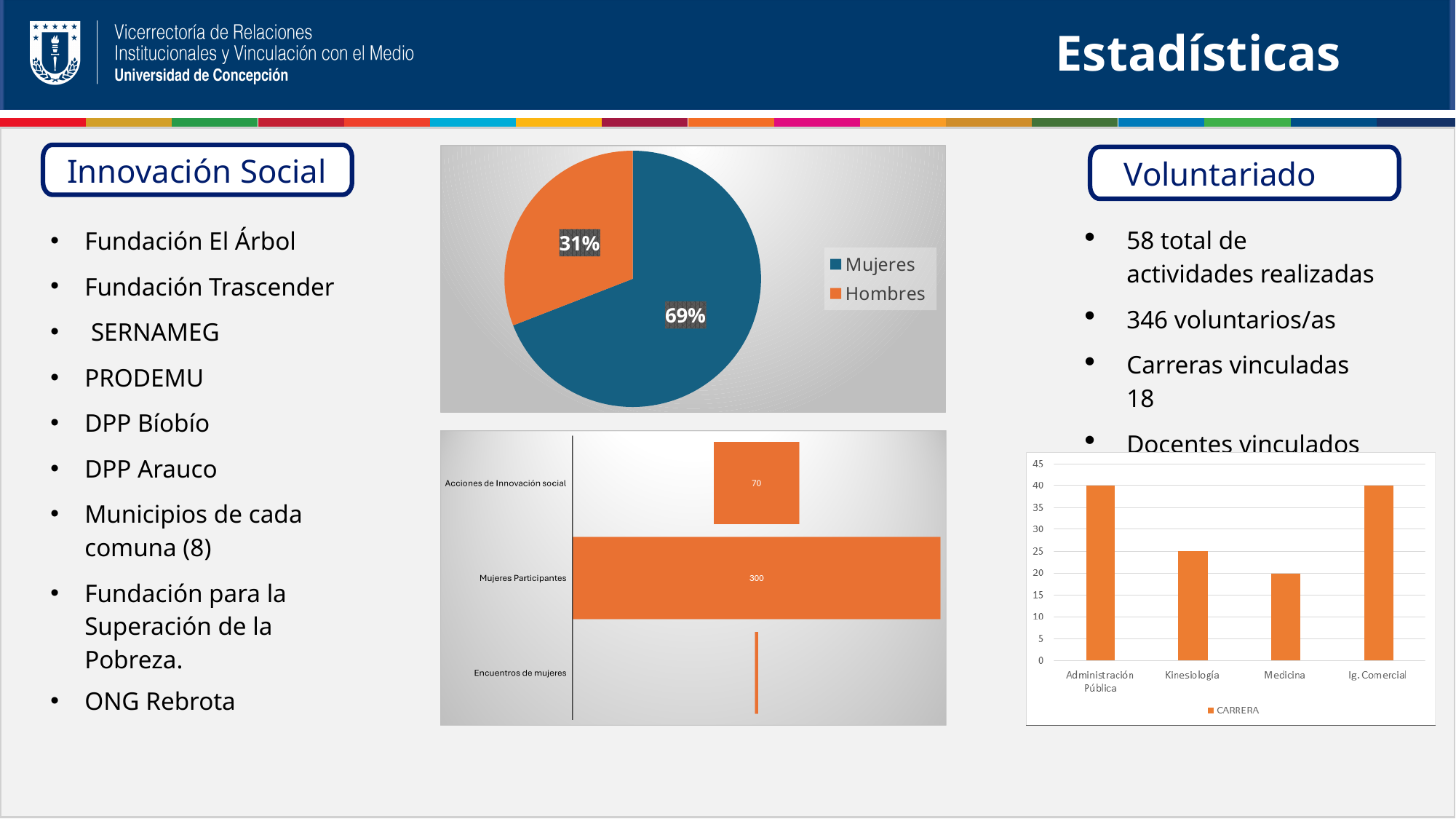
In the pie chart in the middle of the slide, what colour is the Hombres slice? Orange In the bar chart at the bottom right of the slide, which category has the lowest value? Medicina In the pie chart in the middle of the slide, which slice is larger, Mujeres or Hombres? Mujeres In the horizontal bar chart below the pie chart, what is the value for Acciones de Innovación social? 70 In the bar chart at the bottom right of the slide, what is the value for Kinesiología? 25 In the horizontal bar chart below the pie chart, what is the value for Mujeres Participantes? 300 What kind of chart is the chart at the bottom right of the slide with the CARRERA legend? Bar chart In the horizontal bar chart below the pie chart, which category has the lowest value? Encuentros de mujeres In the pie chart in the middle of the slide, what share is labelled for Mujeres? 69% In the pie chart in the middle of the slide, what share is labelled for Hombres? 31% How many entries does the legend of the pie chart in the middle of the slide list? 2 In the horizontal bar chart below the pie chart, what is the difference between Mujeres Participantes and Acciones de Innovación social? 230